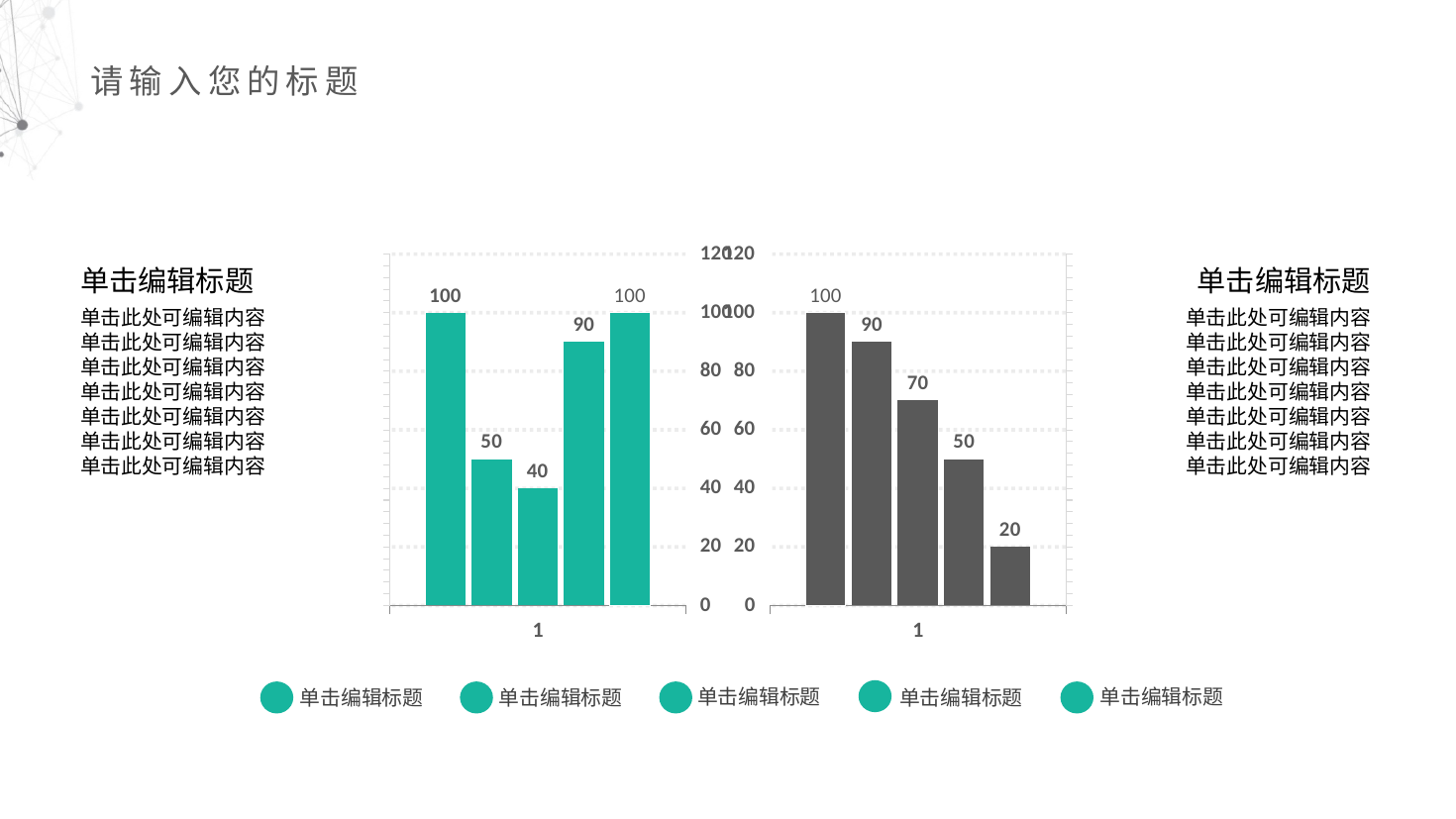
In the left (green) chart, what is the difference between the fourth bar (90) and the second bar (50)? 40 How many bars does the right (grey) chart show? 5 In the right (grey) chart, what is the value of the third bar? 70 In the right (grey) chart, what is the highest bar value? 100 In the left (green) chart, which is larger: the second bar or the fourth bar? the fourth bar (90) In the left (green) chart, what is the value of the first bar? 100 In the left (green) chart, what is the value of the third bar? 40 In the right (grey) chart, what is the value of the last bar? 20 In the left (green) chart, what is the lowest bar value? 40 What type of chart is the left (green) chart? bar chart In the right (grey) chart, do the bar values rise or fall from left to right? fall In the right (grey) chart, what is the difference between the first bar (100) and the last bar (20)? 80